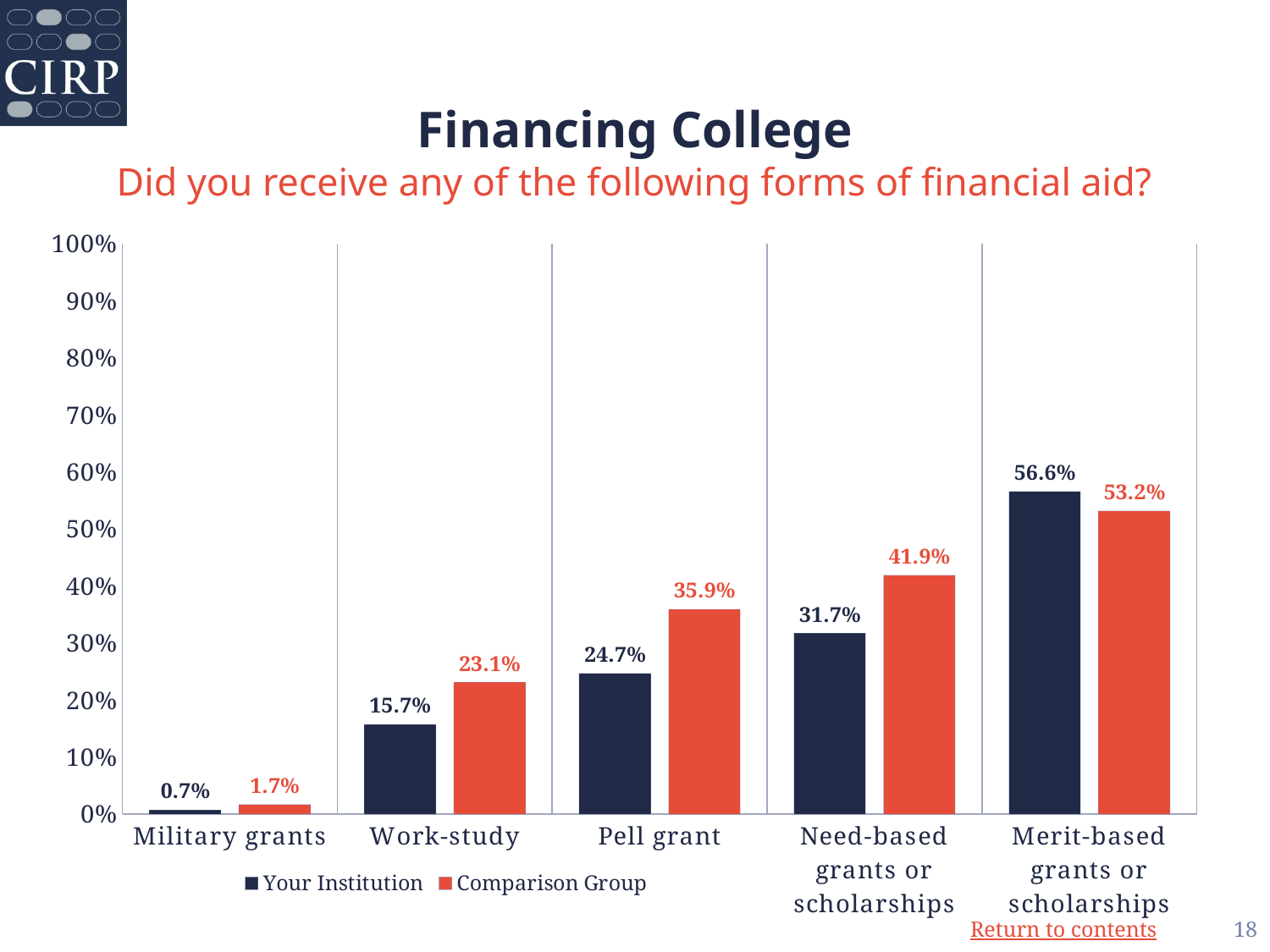
What is the difference between the Comparison Group and Your Institution values for Need-based grants or scholarships? 10.2% For Merit-based grants or scholarships, which series has the larger value, Your Institution or Comparison Group? Your Institution How many series does the legend list? 2 How many categories are shown on the x axis? 5 Which category has the lowest value for Your Institution? Military grants What is the value for Comparison Group for Work-study? 23.1% Which category has the highest value for Comparison Group? Merit-based grants or scholarships What kind of chart is shown on the slide? bar chart What is the value for Your Institution for Pell grant? 24.7% What is the value for Your Institution for Military grants? 0.7% Is the Comparison Group value for Pell grant greater or less than 30%? greater What is the title of the chart? Financing College